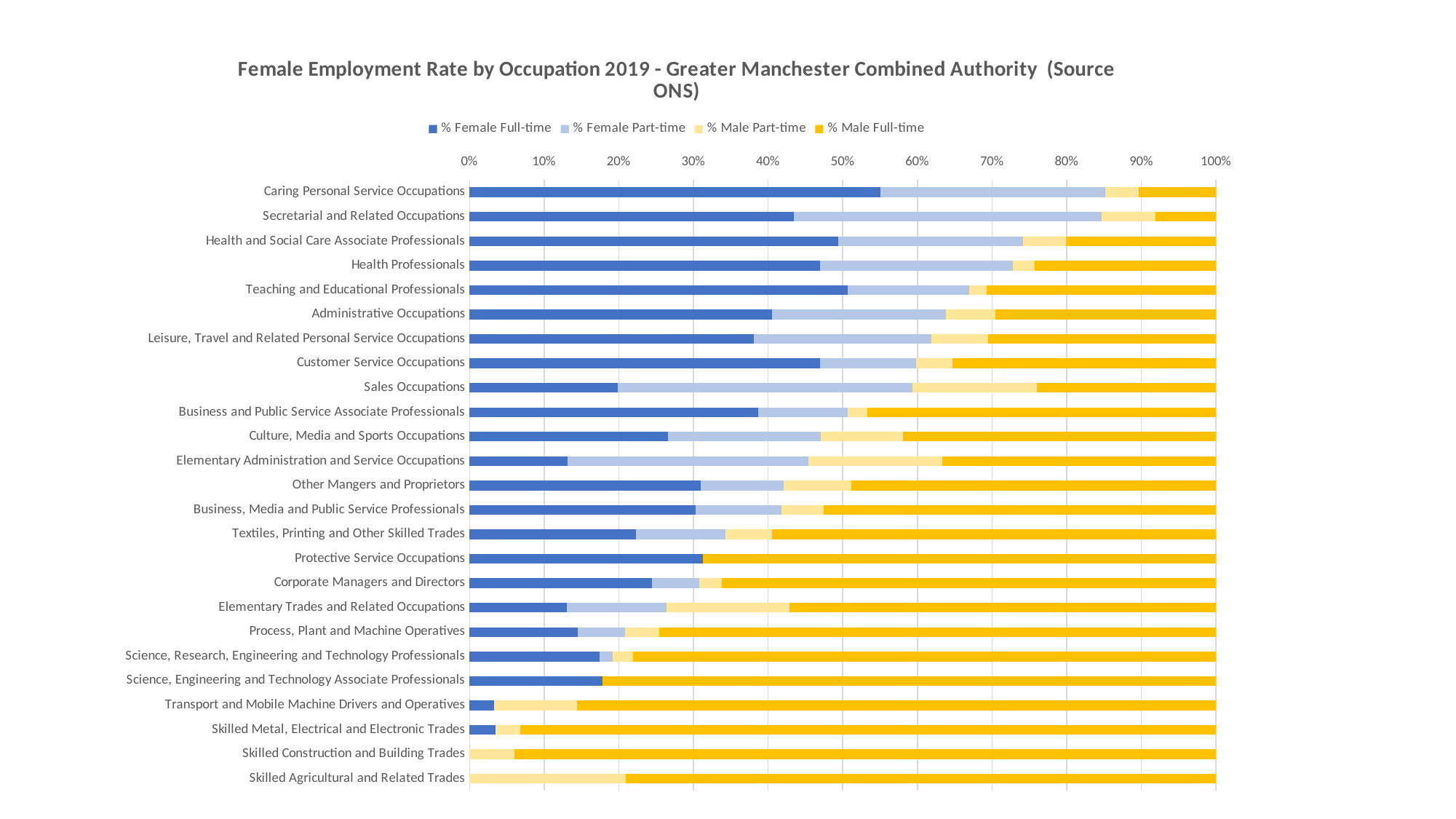
Is the % Female Full-time value for Elementary Administration and Service Occupations greater or less than 20%? less How many series does the legend list? 4 Going down the list of occupations from top to bottom, does the % Female Full-time share generally rise or fall? fall Which has the larger % Female Full-time share: Caring Personal Service Occupations or Sales Occupations? Caring Personal Service Occupations Which has the larger % Male Full-time share: Skilled Metal, Electrical and Electronic Trades or Secretarial and Related Occupations? Skilled Metal, Electrical and Electronic Trades What kind of chart is shown on the slide? Stacked bar chart Which occupation has the highest % Female Full-time share? Caring Personal Service Occupations Is the % Male Full-time value for Skilled Construction and Building Trades greater or less than 90%? greater Is the % Female Full-time value for Caring Personal Service Occupations greater or less than 50%? greater How many occupation categories are plotted on the chart? 25 What is the title of the chart? Female Employment Rate by Occupation 2019 - Greater Manchester Combined Authority (Source ONS)